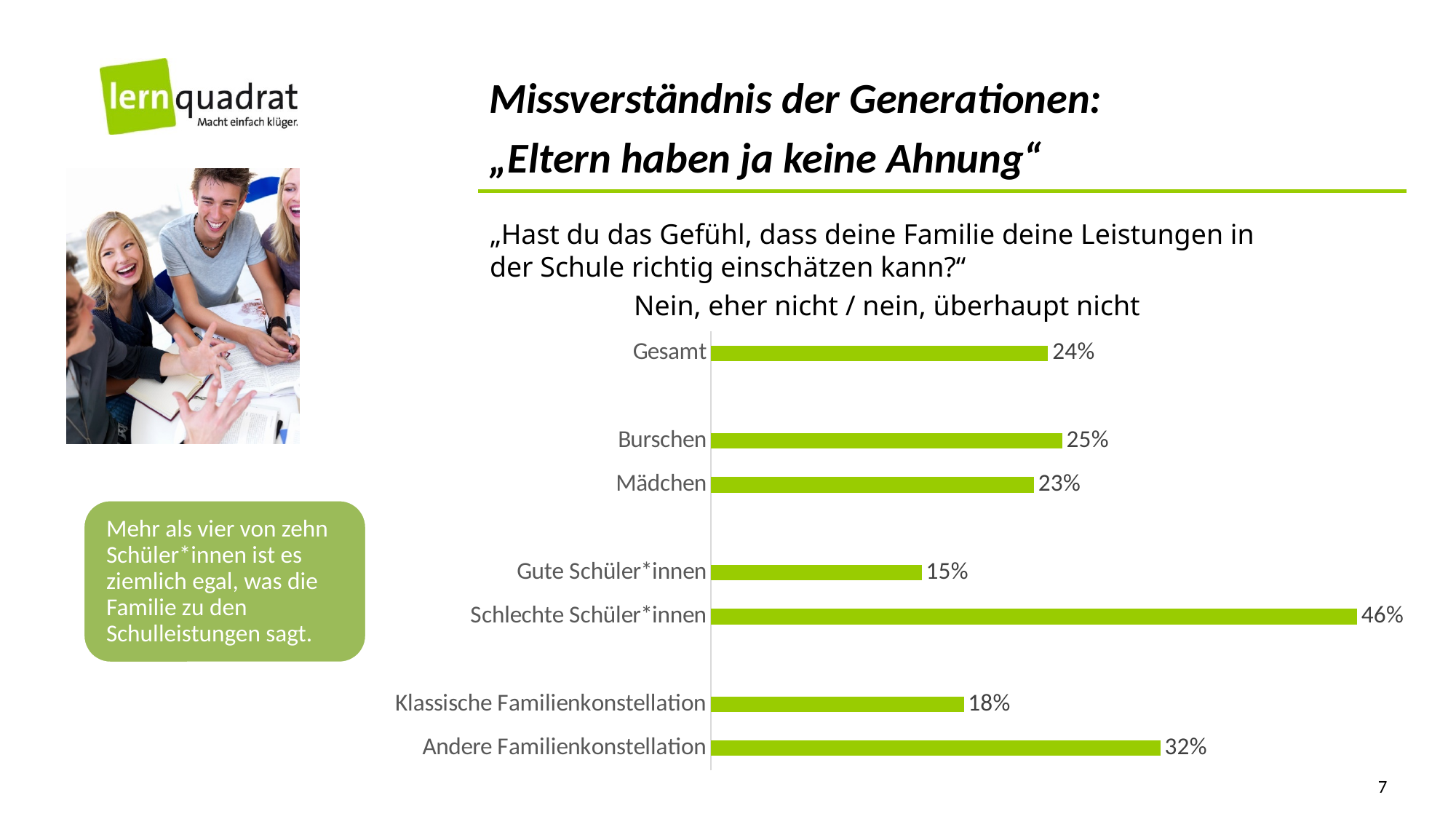
Which category has the lowest value? Gute Schüler*innen Which is larger, the value for Burschen or the value for Mädchen? Burschen What is the difference between Andere Familienkonstellation and Klassische Familienkonstellation? 14 percentage points What is the value for Schlechte Schüler*innen? 46% How many categories are shown in the chart? 7 Which category has the highest value? Schlechte Schüler*innen What is the difference between Schlechte Schüler*innen and Gute Schüler*innen? 31 percentage points What is the title of the chart? Nein, eher nicht / nein, überhaupt nicht What kind of chart is shown on the slide? Bar chart What is the value for Gesamt? 24% What is the value for Mädchen? 23% What is the value for Andere Familienkonstellation? 32%